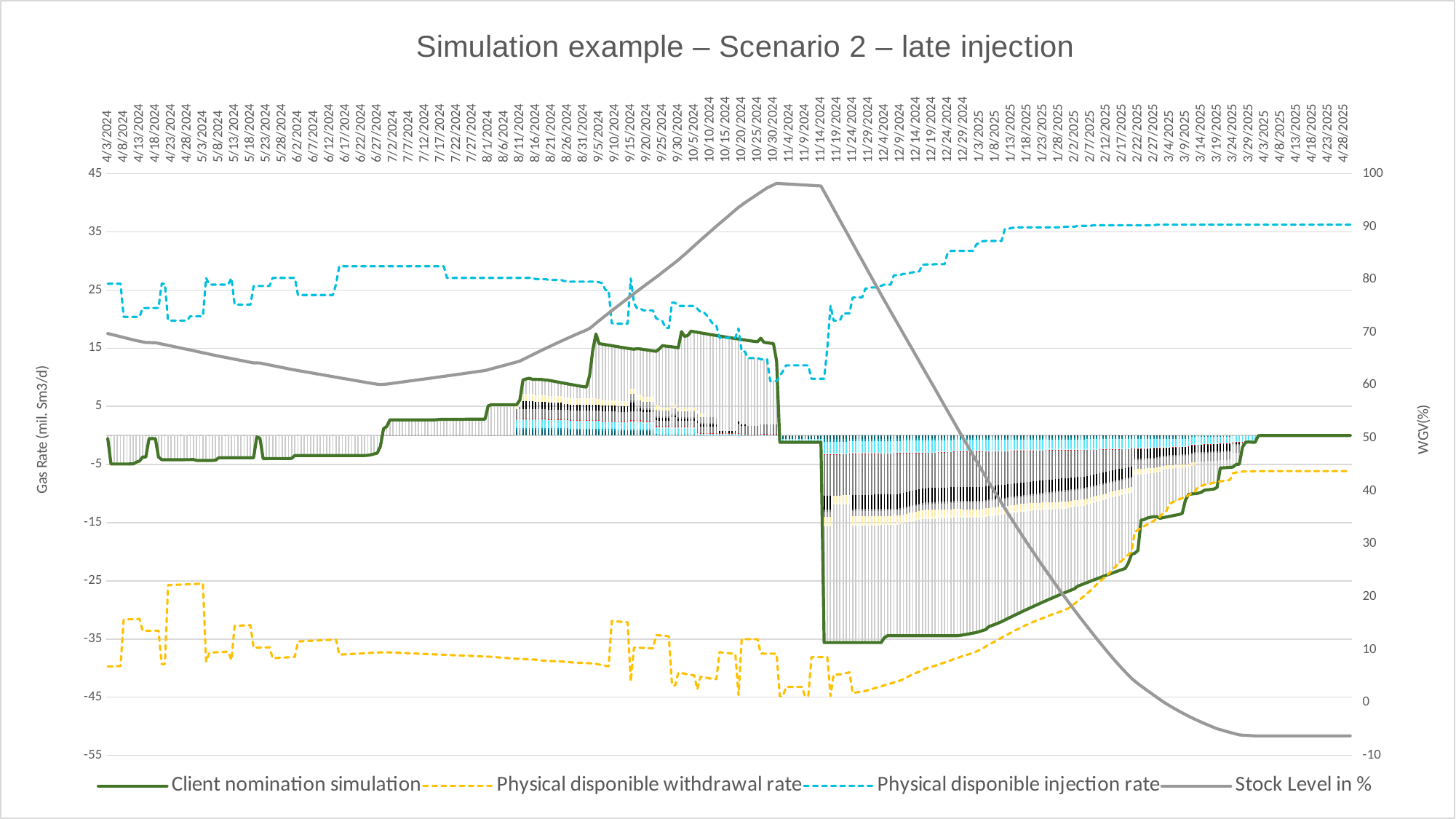
Does Stock Level in % rise or fall between 6/27/2024 and 10/30/2024? rise Does Stock Level in % rise or fall between 10/30/2024 and 4/28/2025? fall Is the value of Client nomination simulation at 11/19/2024 greater or less than -25? less Is the value of Physical disponible withdrawal rate at 4/3/2024 greater or less than -35? less Is the value of Stock Level in % at 4/28/2025 greater or less than 0? less What is the title of the chart? Simulation example – Scenario 2 – late injection Which is larger for Client nomination simulation: the value at 9/5/2024 or the value at 4/3/2024? 9/5/2024 What kind of chart is shown on the slide? combination chart (bars and lines) What is the label of the left vertical axis? Gas Rate (mil. Sm3/d) Which is larger for Stock Level in %: the value at 10/30/2024 or the value at 4/28/2025? 10/30/2024 How many series does the legend list? 4